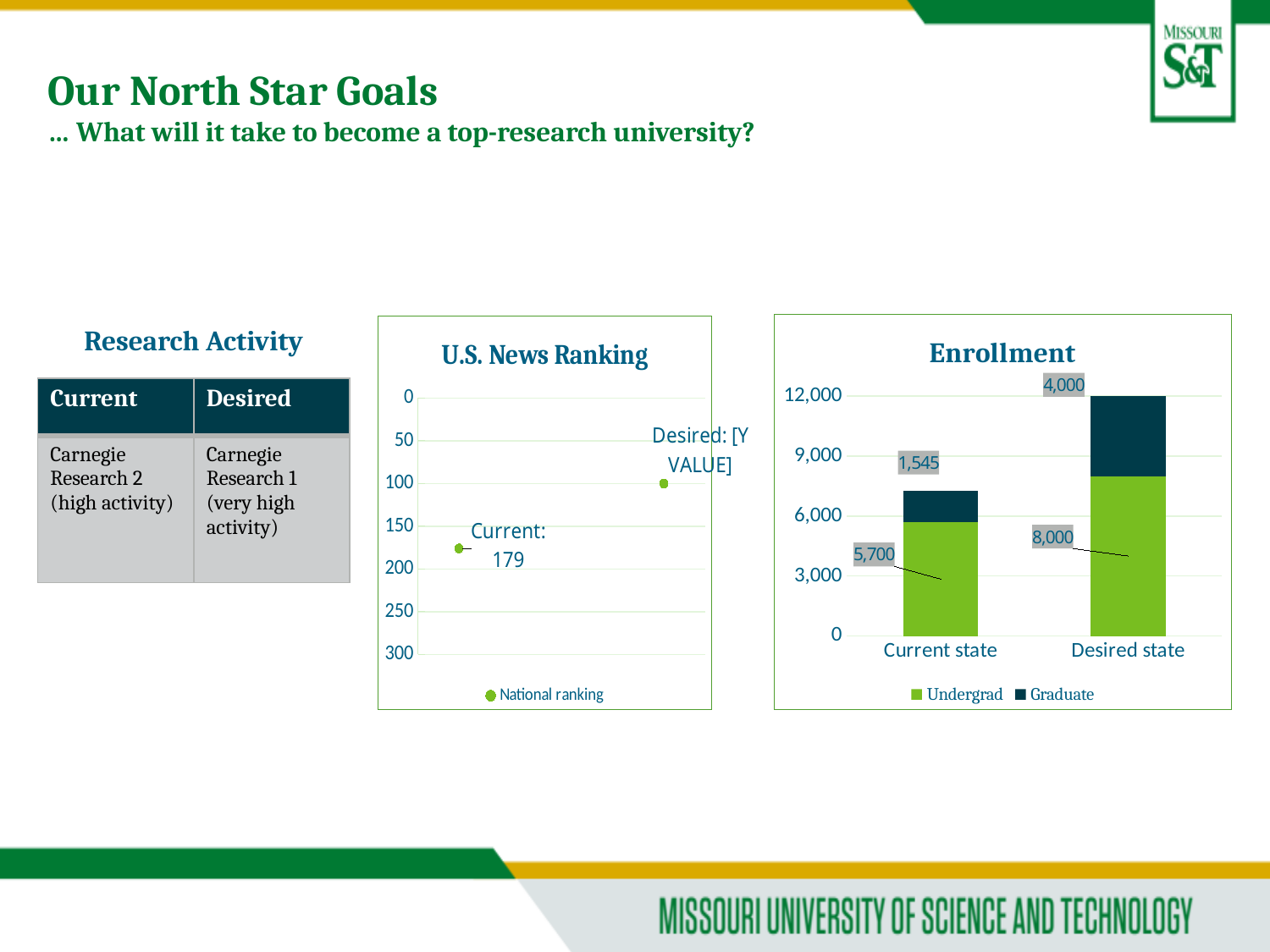
How many series does the legend of the Enrollment chart list? 2 In the Enrollment chart, what is the Graduate value for the Current state? 1,545 In the U.S. News Ranking chart, what is the current national ranking? 179 In the Enrollment chart, what is the Undergrad value for the Current state? 5,700 In the U.S. News Ranking chart, is the desired ranking value greater or less than 150? less In the Enrollment chart, what is the total enrollment for the Current state bar? 7,245 What series name is shown in the legend of the U.S. News Ranking chart? National ranking In the Enrollment chart, what is the Graduate value for the Desired state? 4,000 In the Enrollment chart, what is the total enrollment for the Desired state bar? 12,000 In the Enrollment chart, what is the Undergrad value for the Desired state? 8,000 In the Enrollment chart, how much higher is the Desired state Undergrad value than the Current state Undergrad value? 2,300 What kind of chart is the Enrollment chart? Stacked bar chart